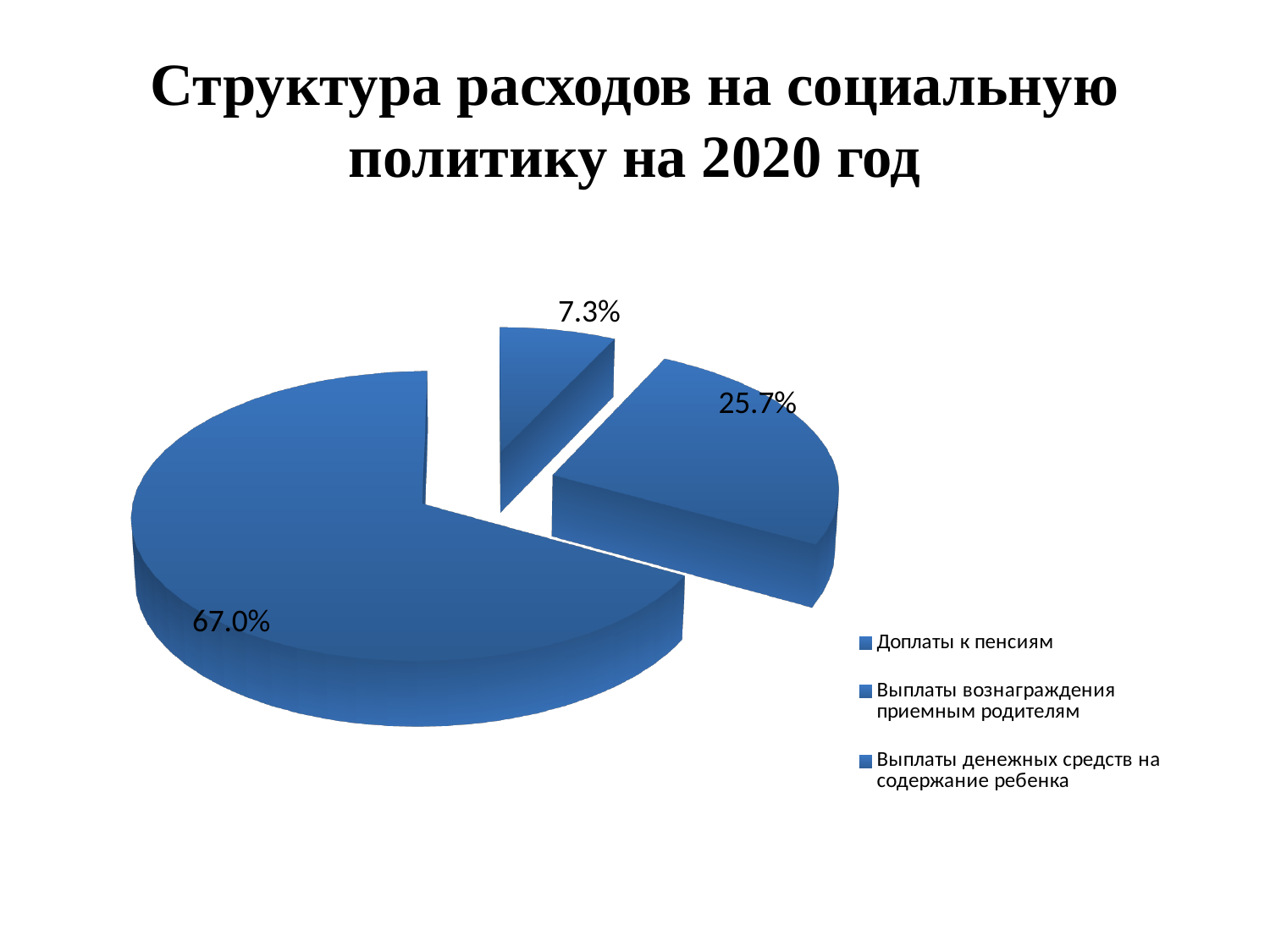
What kind of chart is shown on the slide? pie chart How many slices does the pie chart have? 3 Which is larger, the slice labelled 25.7% or the slice labelled 7.3%? 25.7% How many entries does the legend list? 3 Is the largest slice of the pie chart greater or less than 50%? greater What is the title of the chart on the slide? Структура расходов на социальную политику на 2020 год What is the difference between the 25.7% slice and the 7.3% slice? 18.4% What is the first entry listed in the legend? Доплаты к пенсиям What is the difference between the largest slice (67.0%) and the second-largest slice (25.7%)? 41.3% What is the value of the smallest slice of the pie chart? 7.3% What is the value of the largest slice of the pie chart? 67.0%